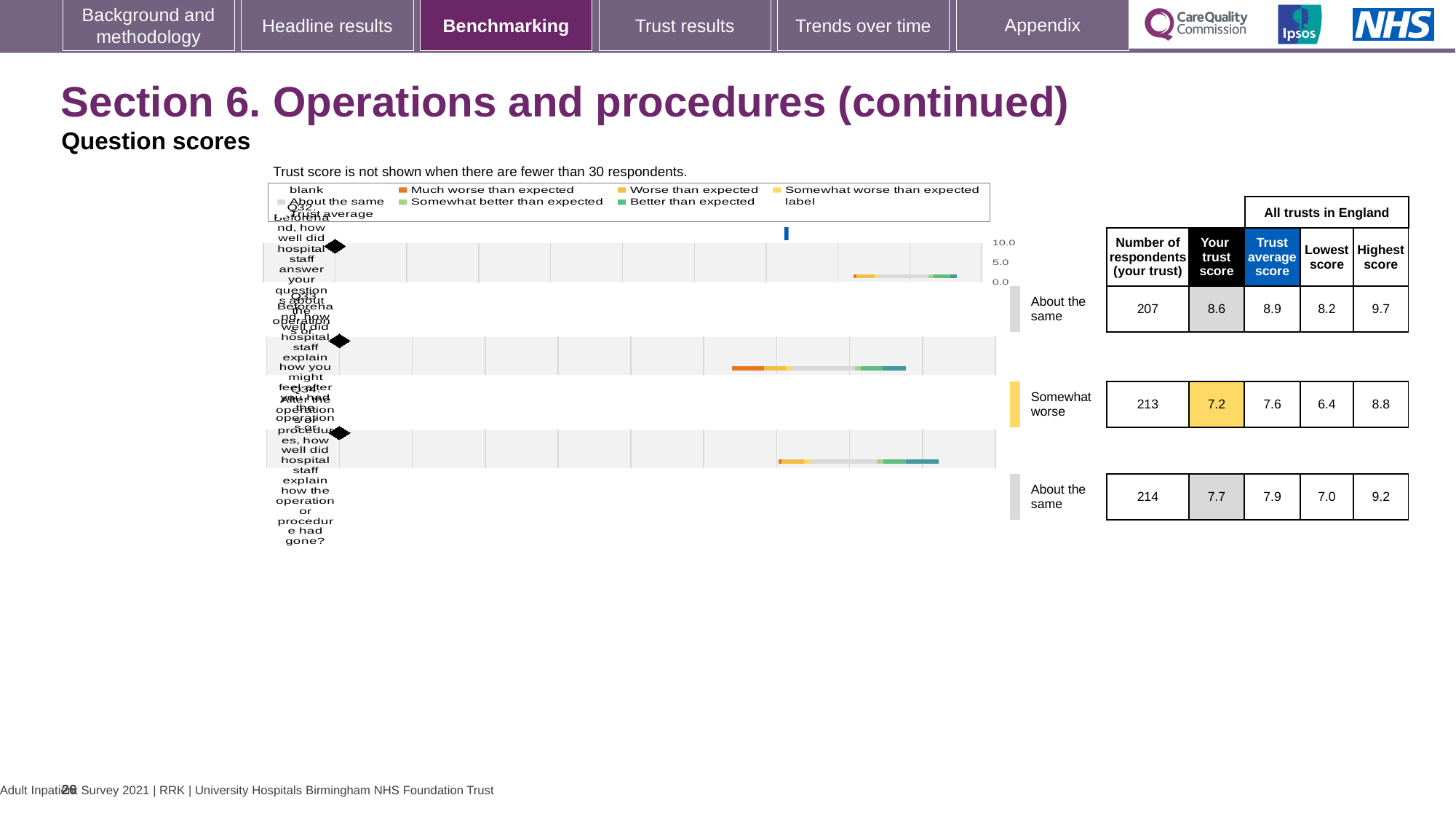
For the third question row (Q34), what is the difference between the 'Highest score' and the 'Lowest score'? 2.2 What is the 'Trust average score' for the third question row (Q34)? 7.9 Is the 'Your trust score' higher for the first question row (Q32) or the third question row (Q34)? The first row (Q32) What is the 'Highest score' for the second question row (Q33)? 8.8 What benchmark category is shown for the second question row (Q33)? Somewhat worse What kind of chart is used to show the question scores? Bar chart How many question rows are plotted in the benchmarking chart? 3 What is the 'Lowest score' for the first question row (Q32)? 8.2 What is the 'Your trust score' for the first question row (Q32) in the benchmarking chart? 8.6 Which question row has the lowest 'Your trust score'? The second row (Q33), 7.2 How many respondents are shown for the second question row (Q33)? 213 For the second question row (Q33), what is the difference between the 'Trust average score' and 'Your trust score'? 0.4